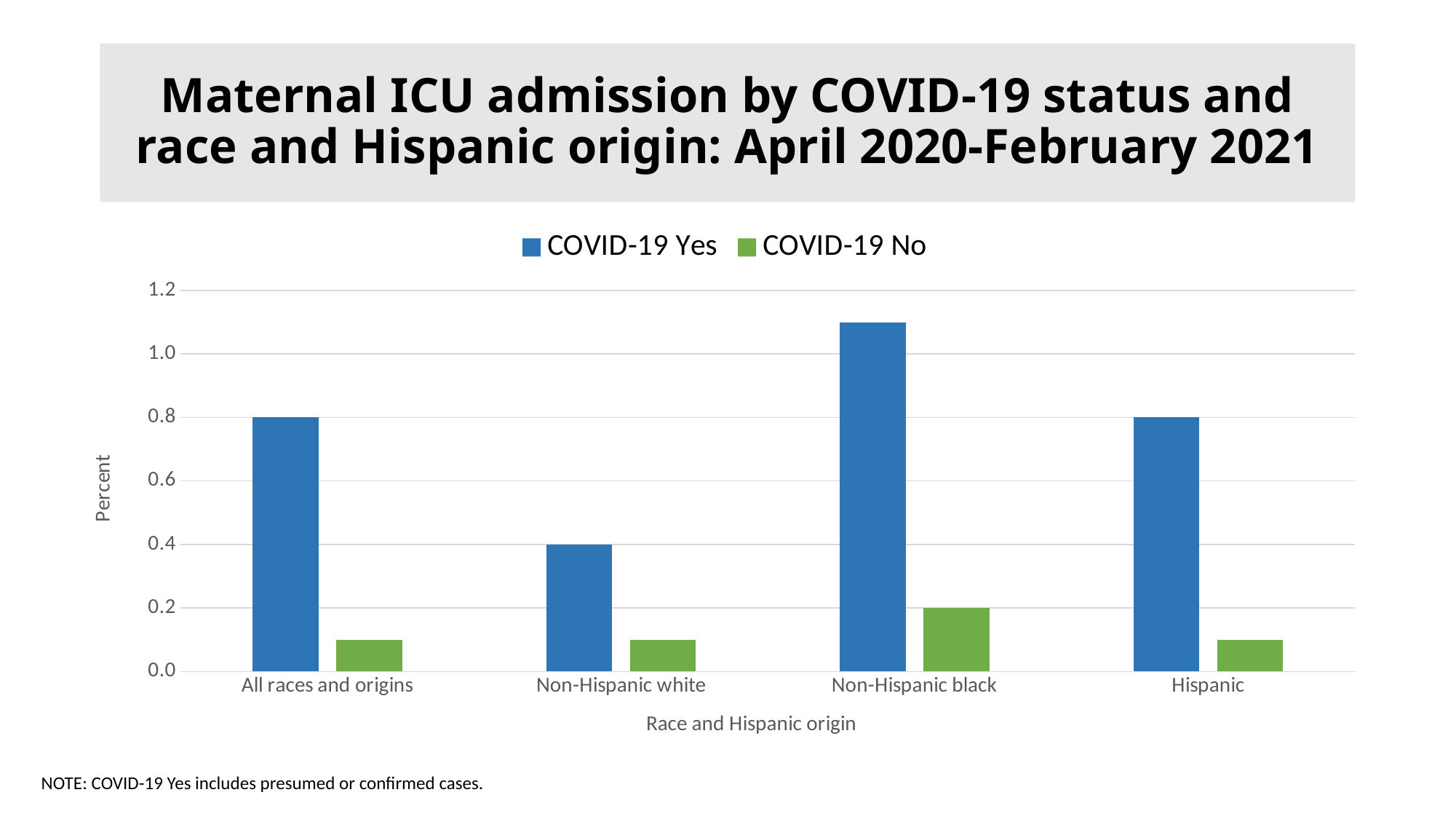
What type of chart is shown on the slide? bar chart How many series does the legend list? 2 What is the COVID-19 Yes value for Non-Hispanic white? 0.4 Is the COVID-19 Yes value for Non-Hispanic black greater or less than 1.0? greater What is the COVID-19 No value for Non-Hispanic black? 0.2 Is the COVID-19 No value for Hispanic greater or less than 0.2? less What is the COVID-19 Yes value for All races and origins? 0.8 How many race and Hispanic origin categories are shown on the x axis? 4 Which is larger for Non-Hispanic black: the COVID-19 Yes value or the COVID-19 No value? COVID-19 Yes Which category has the highest COVID-19 Yes value? Non-Hispanic black What is the difference between the COVID-19 Yes values for All races and origins and Non-Hispanic white? 0.4 Which category has the lowest COVID-19 Yes value? Non-Hispanic white